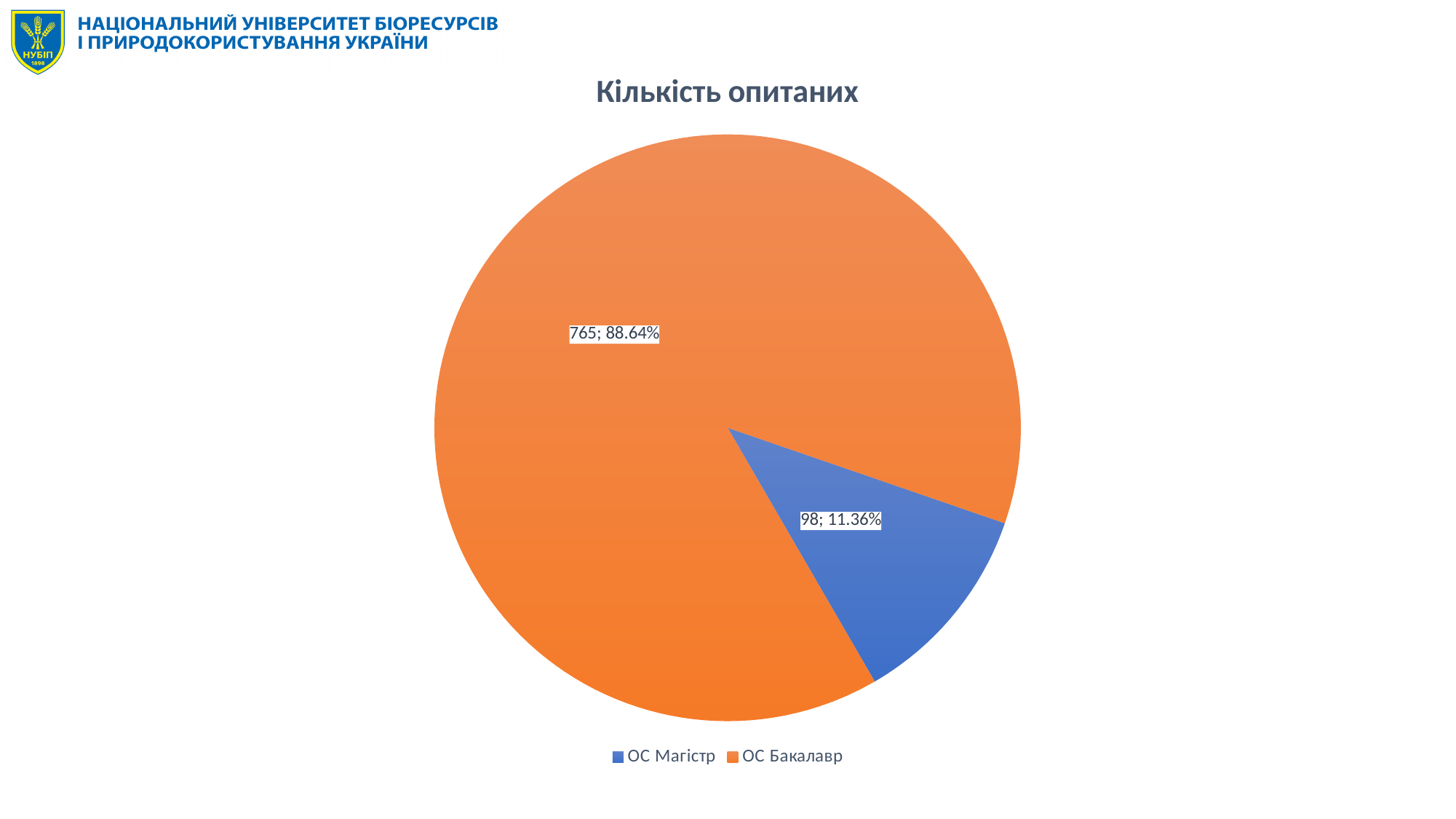
Which category has the smallest slice? ОС Магістр How many entries does the legend list? 2 How many slices does the pie chart have? 2 What is the difference between the number of respondents for ОС Бакалавр and ОС Магістр? 667 What is the title of the chart? Кількість опитаних What is the total number of respondents across both slices? 863 What kind of chart is shown on the slide? pie chart What share of the pie does ОС Магістр represent? 11.36% What is the number of respondents for ОС Магістр? 98 Which category has the largest slice? ОС Бакалавр What is the number of respondents for ОС Бакалавр? 765 What share of the pie does ОС Бакалавр represent? 88.64%